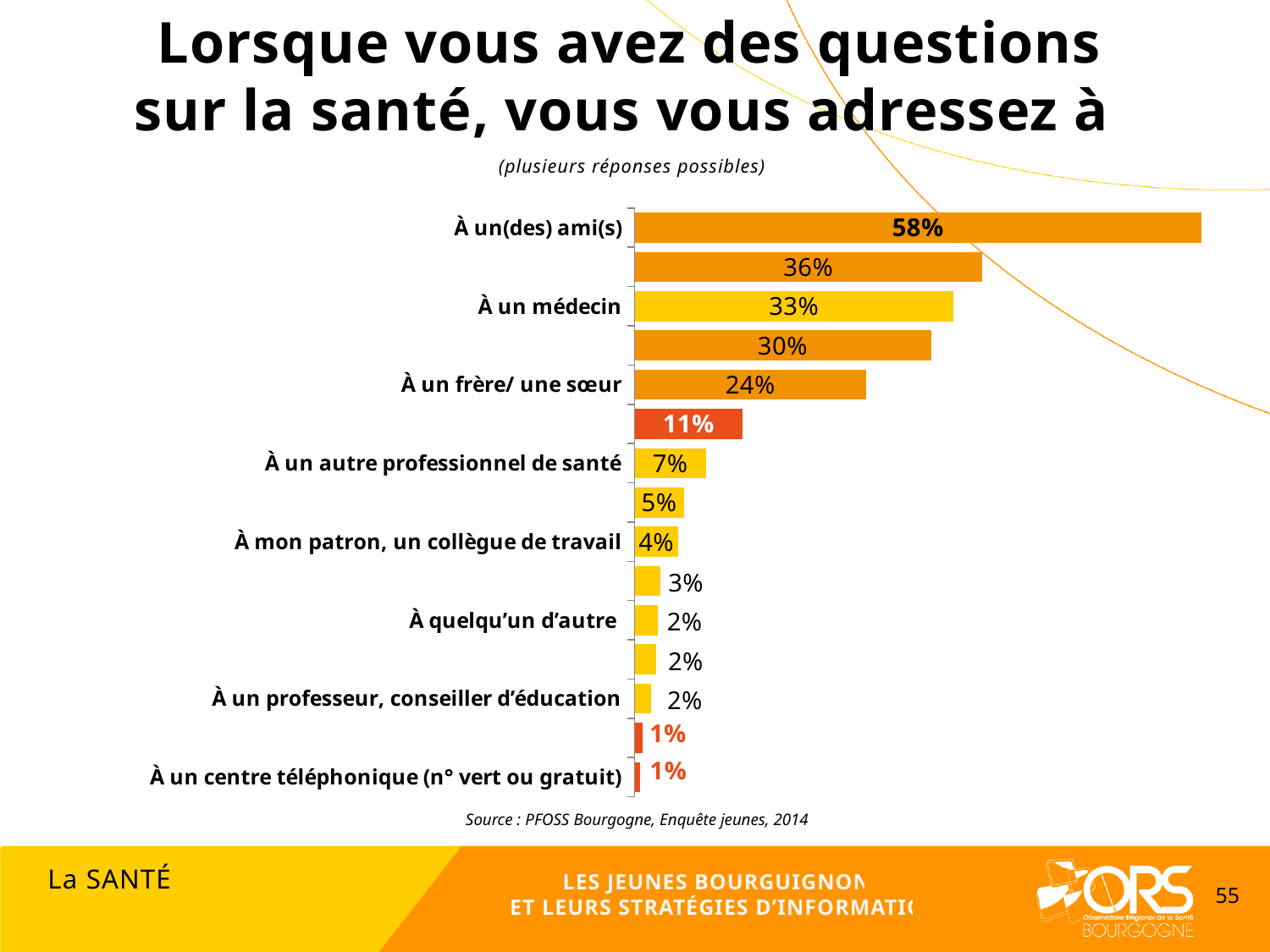
What is the value shown for "À un autre professionnel de santé"? 7% Which category has the highest value in the chart? À un(des) ami(s) What is the difference in percentage points between "À un(des) ami(s)" and "À un médecin"? 25 What is the value shown for "À un frère/ une sœur"? 24% Which is larger, the value for "À un médecin" or the value for "À un frère/ une sœur"? À un médecin What is the value shown for "À un centre téléphonique (n° vert ou gratuit)"? 1% What type of chart is shown on the slide? Bar chart What is the value shown for "À mon patron, un collègue de travail"? 4% How many bars are plotted in the chart? 15 What percentage of respondents say they turn to "À un(des) ami(s)" for health questions? 58% What is the lowest value shown on any bar in the chart? 1% What is the value shown for "À un médecin"? 33%